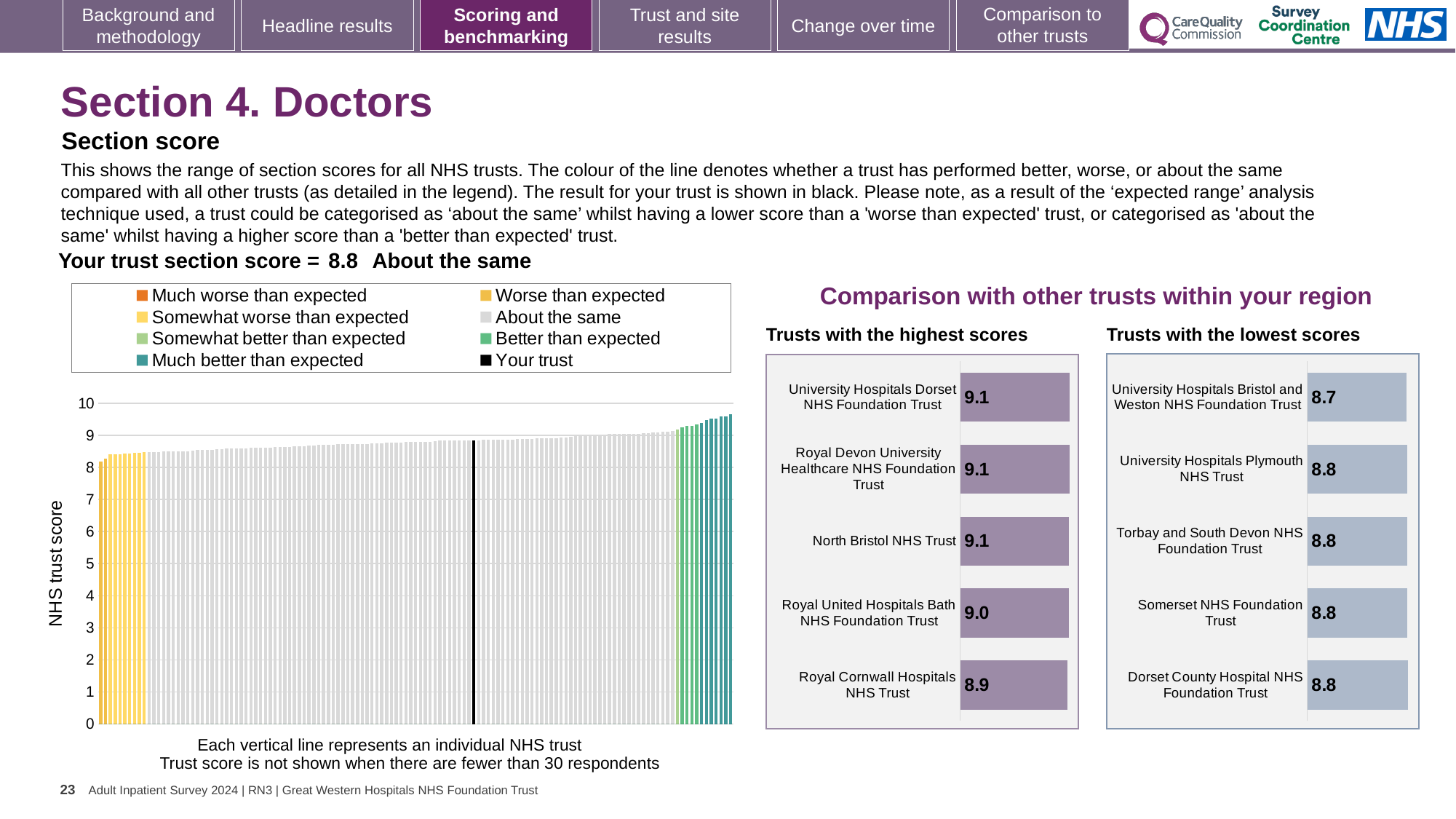
What kind of chart is the NHS trust score chart on the left of the slide? Bar chart In the 'Trusts with the highest scores' chart, what is the difference between the score for University Hospitals Dorset NHS Foundation Trust and the score for Royal Cornwall Hospitals NHS Trust? 0.2 In the NHS trust score chart on the left, do the values rise or fall from left to right along the x axis? Rise In the 'Trusts with the highest scores' chart, what is the score for Royal Cornwall Hospitals NHS Trust? 8.9 How many trusts are listed in the 'Trusts with the lowest scores' chart? 5 In the 'Trusts with the highest scores' chart, which trust has the lowest score? Royal Cornwall Hospitals NHS Trust In the 'Trusts with the lowest scores' chart, what is the score for University Hospitals Bristol and Weston NHS Foundation Trust? 8.7 In the 'Trusts with the highest scores' chart, what is the score for Royal United Hospitals Bath NHS Foundation Trust? 9.0 In the 'Trusts with the highest scores' chart, which has the larger score: Royal United Hospitals Bath NHS Foundation Trust or Royal Cornwall Hospitals NHS Trust? Royal United Hospitals Bath NHS Foundation Trust How many entries does the legend of the NHS trust score chart on the left list? 8 In the 'Trusts with the lowest scores' chart, which trust has the lowest score? University Hospitals Bristol and Weston NHS Foundation Trust In the NHS trust score chart on the left, is the value for the black 'Your trust' bar greater or less than 8? greater